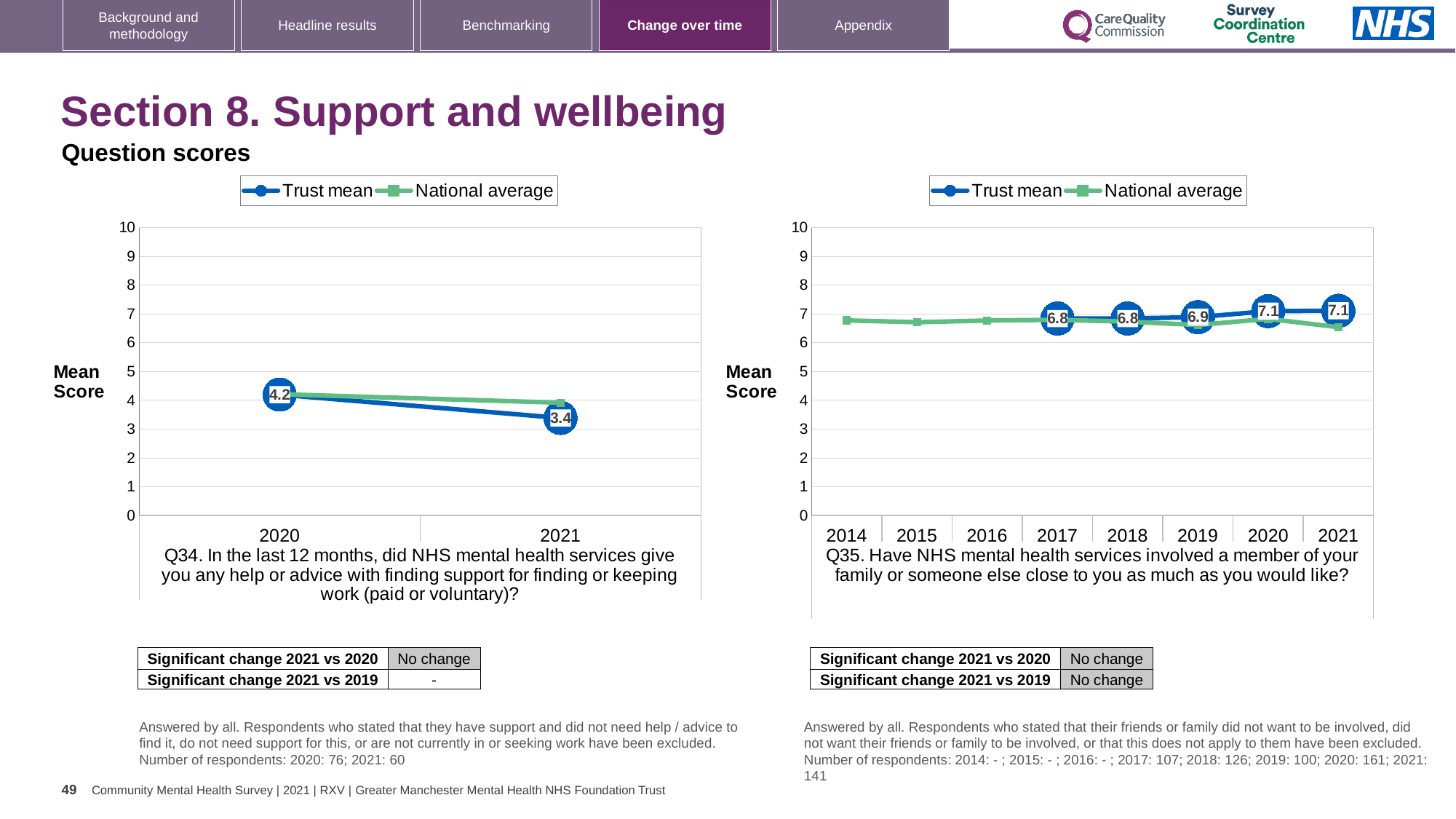
In the Q34 chart on the left, what is the Trust mean for 2020? 4.2 How many series does the legend of the Q35 chart on the right list? 2 In the Q34 chart on the left, does the Trust mean rise or fall from 2020 to 2021? fall In the Q35 chart on the right, what is the Trust mean for 2021? 7.1 In the Q34 chart on the left, by how much did the Trust mean fall from 2020 to 2021? 0.8 In the Q35 chart on the right, how many years are shown on the x axis? 8 In the Q35 chart on the right, what is the difference between the Trust mean in 2021 and in 2017? 0.3 In the Q35 chart on the right, which year has the lowest labelled Trust mean? 2017 and 2018 (6.8) What type of chart is the Q34 chart on the left? Line chart In the Q35 chart on the right, what is the Trust mean for 2019? 6.9 In the Q34 chart on the left, what is the Trust mean for 2021? 3.4